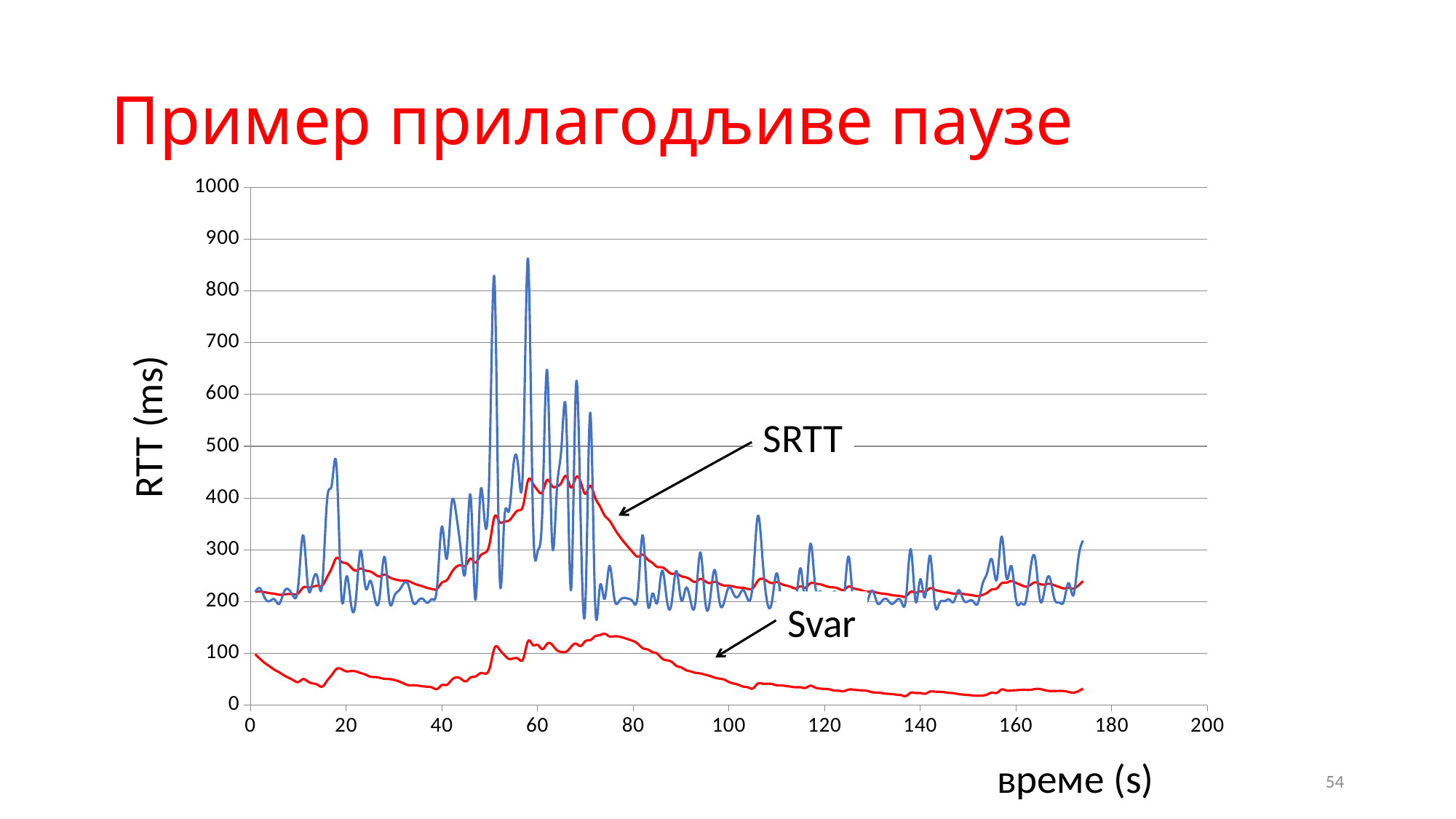
Does the Svar line rise or fall between 80 s and 120 s? fall Which line is higher at time 100 s, SRTT or Svar? SRTT Is the value of the SRTT line at time 100 s greater or less than 300? less What is the label of the vertical axis? RTT (ms) Is the value of the Svar line at time 120 s greater or less than 100? less Is the highest peak of the blue line greater or less than 800? greater What is the label of the horizontal axis? време (s) What kind of chart is shown on the slide? line chart How many lines are plotted on the chart? 3